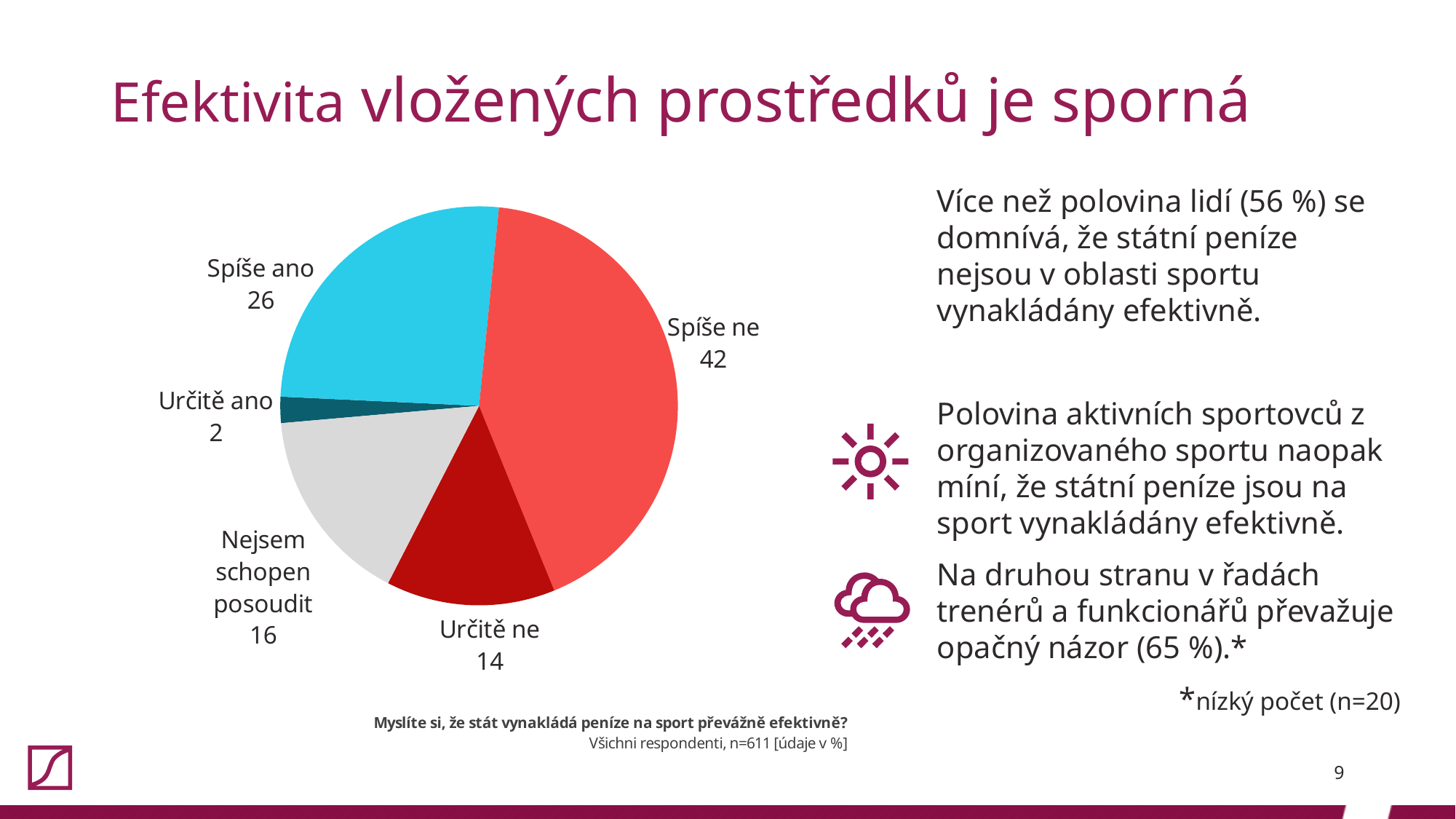
What is the value for "Určitě ano"? 2 What is the value for "Nejsem schopen posoudit"? 16 What is the difference between the values for "Spíše ne" and "Spíše ano"? 16 What is the value for "Spíše ne"? 42 What colour is the "Spíše ano" slice? light blue Which category has the largest slice of the pie? Spíše ne Which is larger, the value for "Určitě ne" or the value for "Spíše ano"? Spíše ano How many categories does the pie chart have? 5 What kind of chart is shown on the slide? pie chart Which category has the smallest slice of the pie? Určitě ano What is the combined value of "Spíše ne" and "Určitě ne"? 56 What is the sample size (n) stated below the chart? n=611